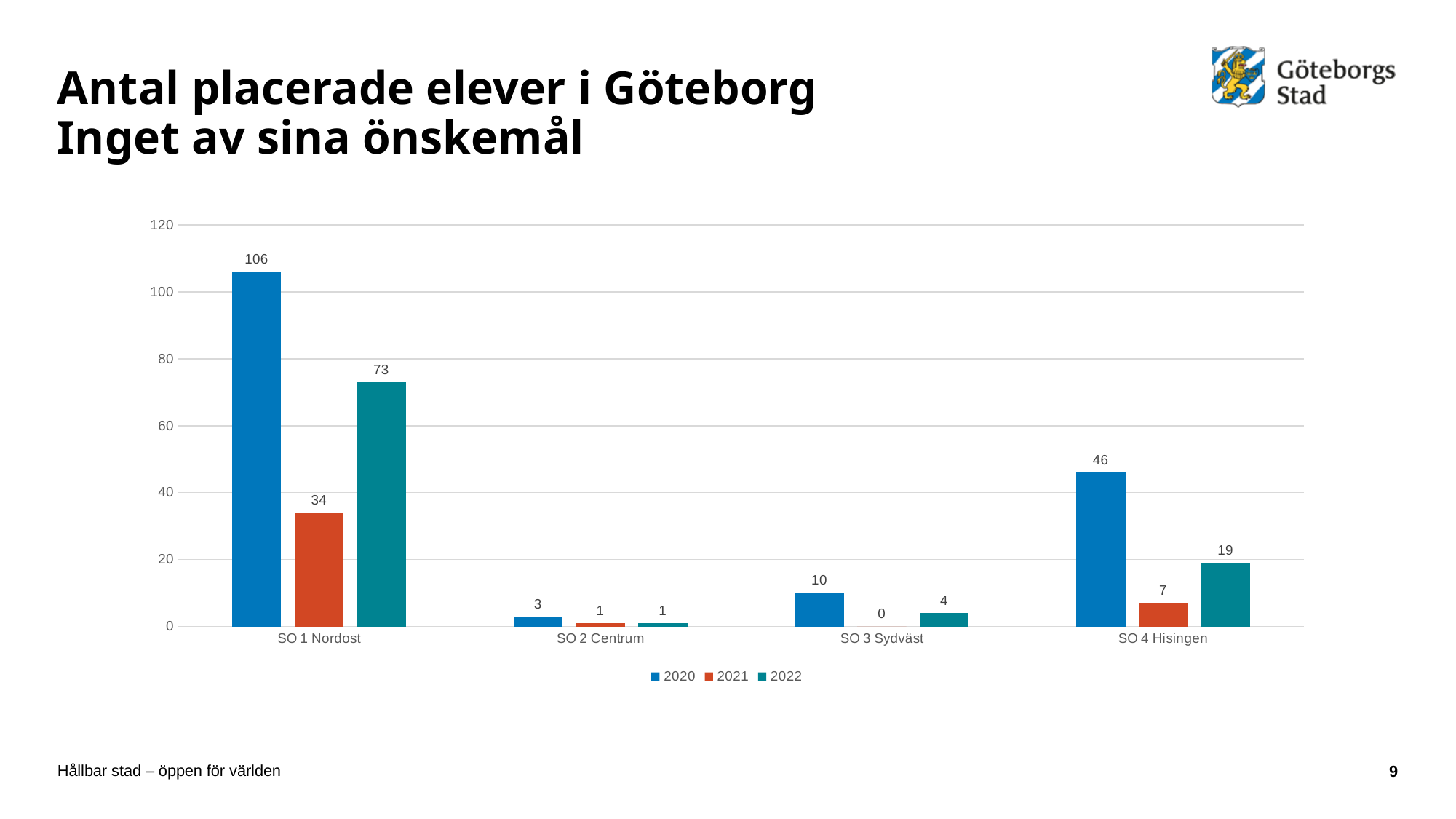
What is the value for SO 1 Nordost in 2020? 106 How many categories are shown on the x axis? 4 What is the value for SO 4 Hisingen in 2022? 19 What is the value for SO 3 Sydväst in 2021? 0 How many series does the legend list? 3 Is the 2020 value for SO 1 Nordost greater or less than 100? greater What is the difference between the 2020 and 2022 values for SO 1 Nordost? 33 Which category has the lowest value in 2020? SO 2 Centrum What kind of chart is shown on the slide? bar chart Which is larger: the 2021 value for SO 1 Nordost or the 2020 value for SO 4 Hisingen? SO 4 Hisingen in 2020 Which series is shown in orange in the legend? 2021 Which category has the highest value in 2022? SO 1 Nordost